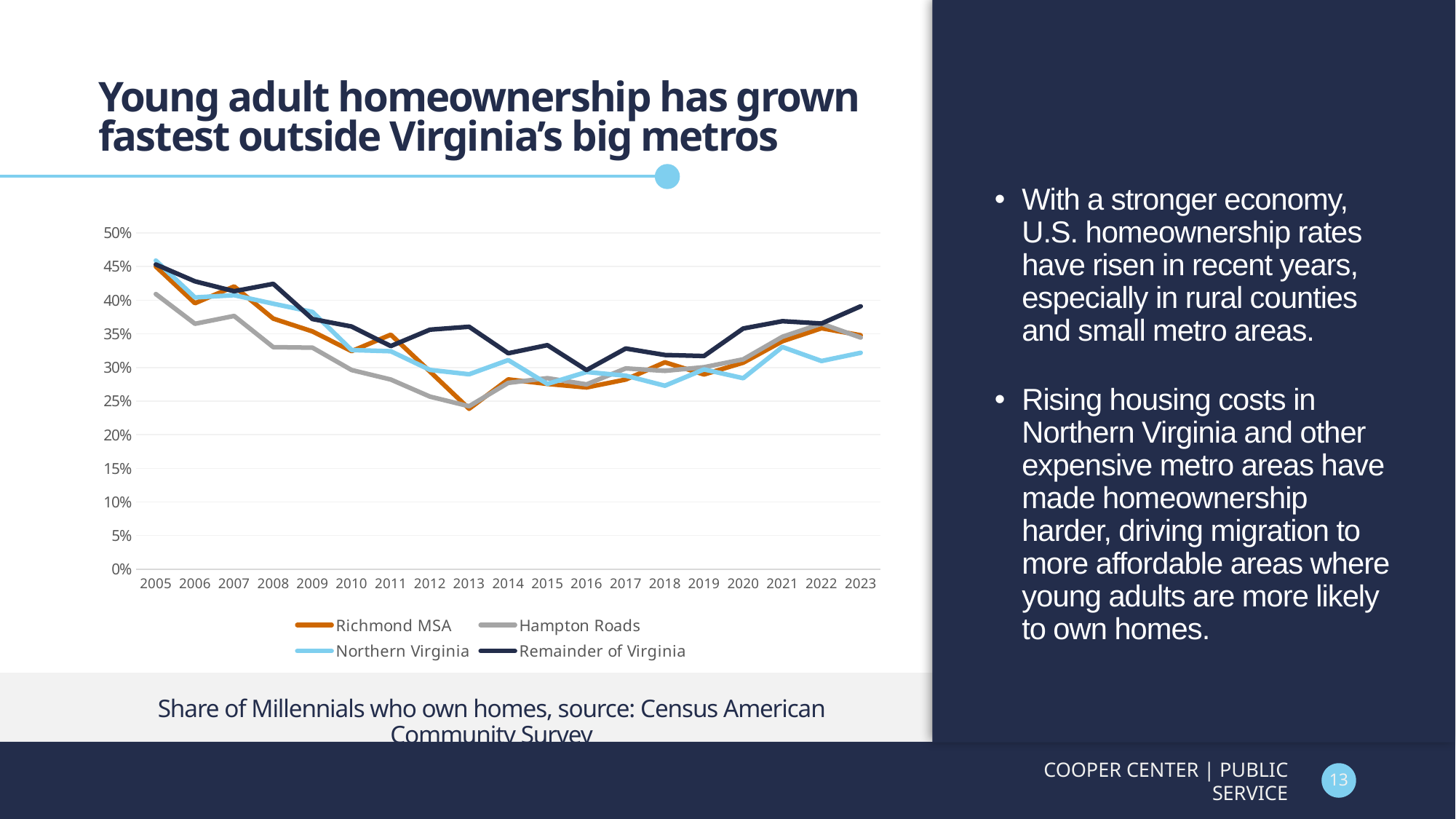
Which series has the highest value in 2023? Remainder of Virginia Is the value for Northern Virginia in 2023 greater or less than 35%? less How many years are plotted along the x axis of the chart? 19 Is the value for Hampton Roads in 2005 greater or less than 45%? less In 2013, which is larger: the value for Remainder of Virginia or the value for Richmond MSA? Remainder of Virginia Does the Richmond MSA line rise or fall between 2005 and 2013? Fall Is the value for Richmond MSA in 2016 greater or less than 30%? less What kind of chart is shown on the slide? Line chart Which series has the lowest value in 2023? Northern Virginia How many series does the chart's legend list? 4 What colour is the Richmond MSA line in the chart? Orange